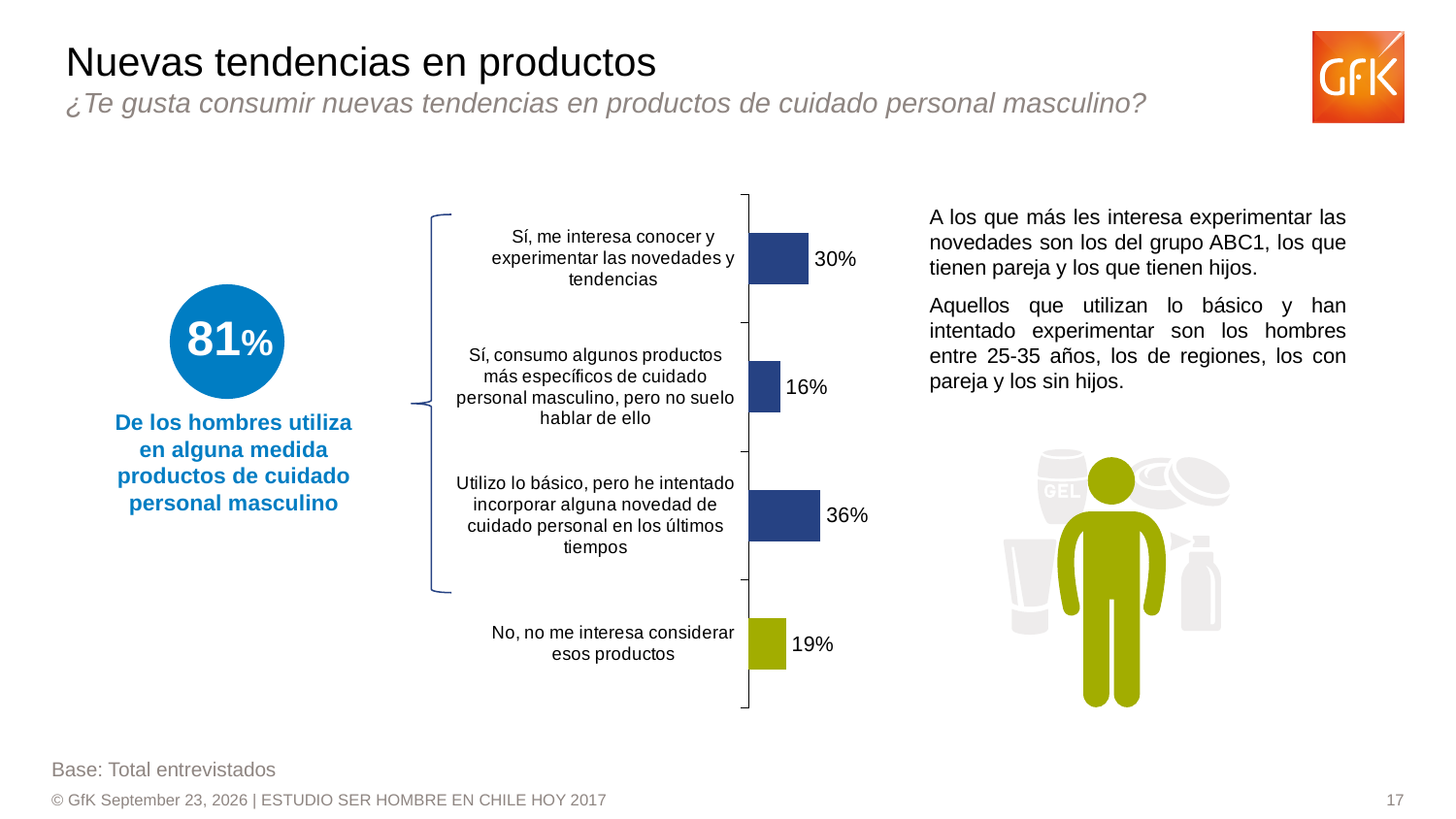
What is the difference between the value for "No, no me interesa considerar esos productos" and "Sí, consumo algunos productos más específicos..."? 3% What is the value for "Utilizo lo básico, pero he intentado incorporar alguna novedad de cuidado personal en los últimos tiempos"? 36% Which category has the highest value? Utilizo lo básico, pero he intentado incorporar alguna novedad de cuidado personal en los últimos tiempos What percentage is shown in the blue circle to the left of the chart? 81% Which is larger: the value for "No, no me interesa considerar esos productos" or for "Sí, consumo algunos productos más específicos..."? No, no me interesa considerar esos productos What is the value for "Sí, me interesa conocer y experimentar las novedades y tendencias"? 30% What is the value for "Sí, consumo algunos productos más específicos de cuidado personal masculino, pero no suelo hablar de ello"? 16% What kind of chart is shown on the slide? Bar chart How many categories are shown in the chart? 4 What is the value for "No, no me interesa considerar esos productos"? 19% What is the difference between the value for "Utilizo lo básico..." (36%) and "Sí, me interesa conocer y experimentar..." (30%)? 6% Which category has the lowest value? Sí, consumo algunos productos más específicos de cuidado personal masculino, pero no suelo hablar de ello